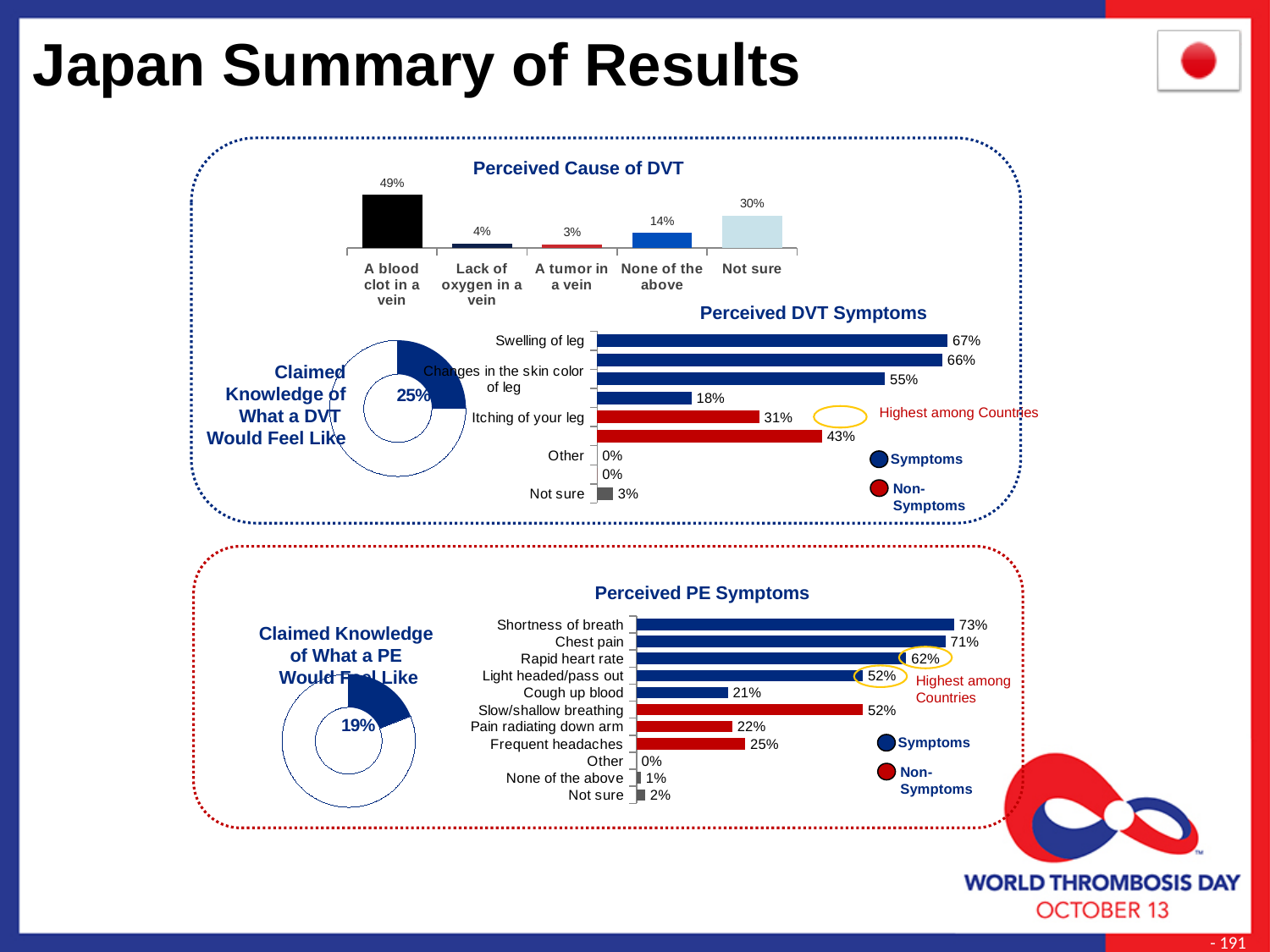
How many series does the legend of the Perceived PE Symptoms chart list? 2 What percentage is shown in the 'Claimed Knowledge of What a PE Would Feel Like' donut chart? 19% In the Perceived Cause of DVT chart, what percentage chose 'A blood clot in a vein'? 49% In the Perceived PE Symptoms chart, which is larger: 'Cough up blood' or 'Frequent headaches'? Frequent headaches What type of chart is the Perceived Cause of DVT chart? Bar chart In the Perceived Cause of DVT chart, which category has the lowest value? A tumor in a vein What percentage is shown in the 'Claimed Knowledge of What a DVT Would Feel Like' donut chart? 25% How many categories are shown in the Perceived Cause of DVT chart? 5 In the Perceived PE Symptoms chart, what is the difference between 'Chest pain' and 'Rapid heart rate'? 9% In the Perceived DVT Symptoms chart, what is the highest value shown? 67% In the Perceived PE Symptoms chart, what is the value for 'Shortness of breath'? 73% In the Perceived Cause of DVT chart, what is the difference between 'Not sure' and 'None of the above'? 16%